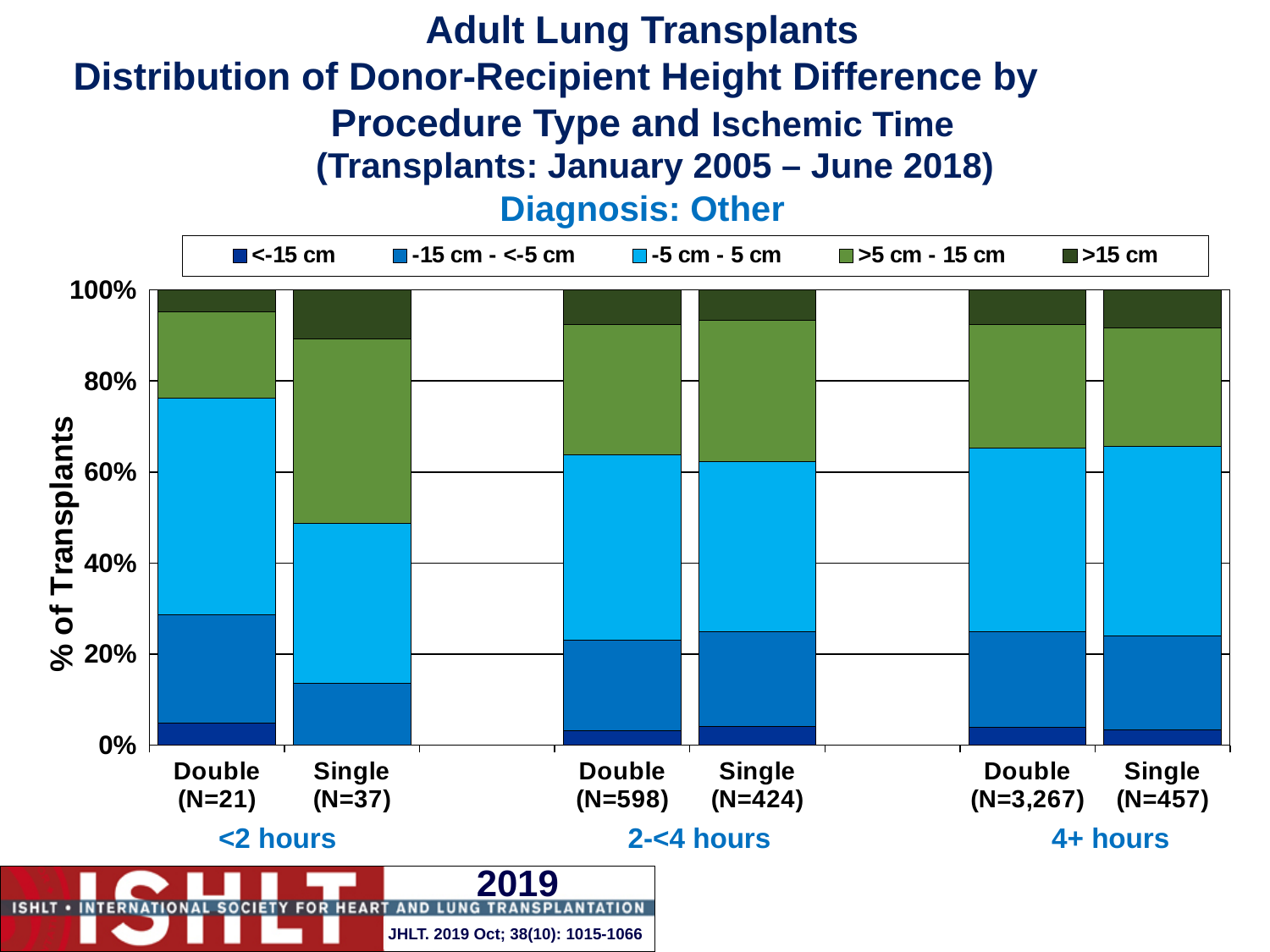
In the <2 hours group, which bar has the larger -5 cm - 5 cm segment, Double (N=21) or Single (N=37)? Double (N=21) In the <2 hours group, which bar has the larger >15 cm segment, Double (N=21) or Single (N=37)? Single (N=37) How many ischemic time groups are shown along the x axis? 3 What kind of chart is shown on the slide? Stacked bar chart Which bar has the largest >5 cm - 15 cm segment? Single (N=37), <2 hours Is the >5 cm - 15 cm segment for Single (N=37) in the <2 hours group greater or less than 20%? greater Is the -5 cm - 5 cm segment for Double (N=21) in the <2 hours group greater or less than 40%? greater What is the label of the y axis? % of Transplants How many series does the legend list? 5 Which bar has the smallest -15 cm - <-5 cm segment? Single (N=37), <2 hours What is the N for the Double bar in the 4+ hours group? N=3,267 How many bars are plotted in the chart? 6